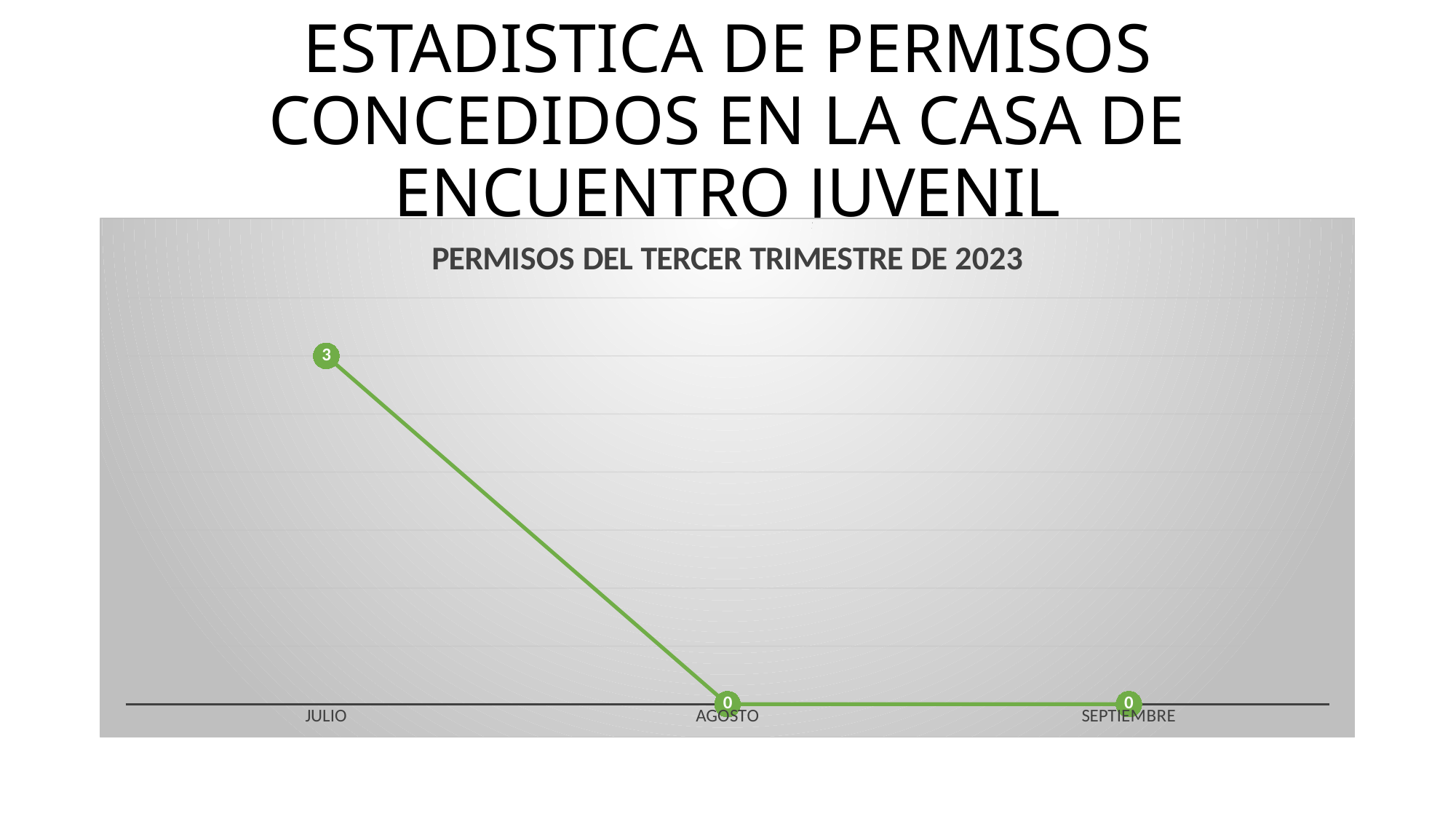
What is the difference between the values for JULIO and AGOSTO? 3 How many months are plotted on the chart? 3 Which month has the highest value? JULIO What kind of chart is shown? line chart Do the values rise or fall from JULIO to AGOSTO? fall What is the value for JULIO? 3 Which is larger, the value for JULIO or the value for SEPTIEMBRE? JULIO What is the value for AGOSTO? 0 What is the value for SEPTIEMBRE? 0 What colour is the line on the chart? green What is the title of the chart? PERMISOS DEL TERCER TRIMESTRE DE 2023